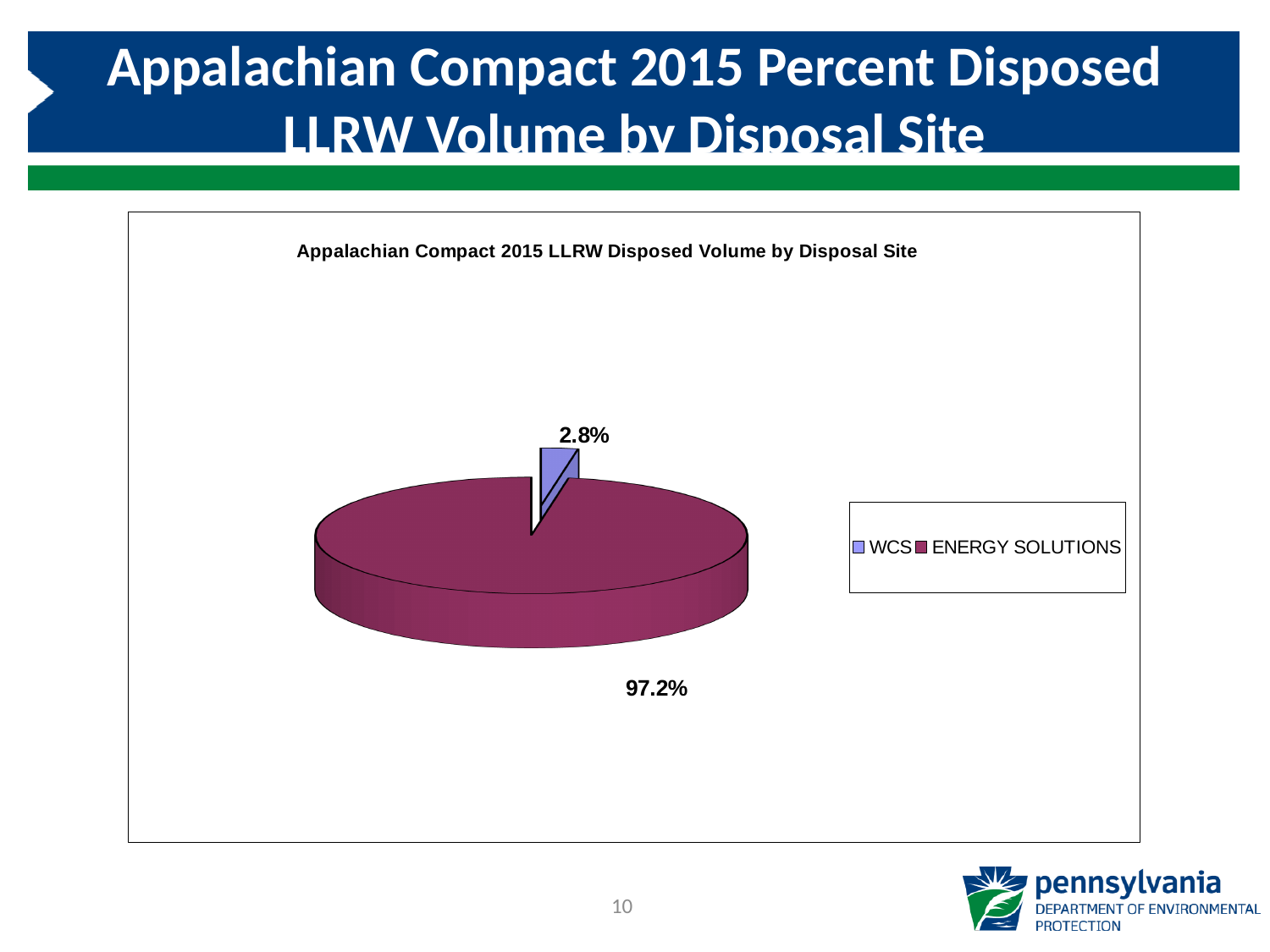
What share of the pie does ENERGY SOLUTIONS account for? 97.2% How many slices does the pie chart have? 2 What is the title of the chart? Appalachian Compact 2015 LLRW Disposed Volume by Disposal Site Which disposal site has the largest share of the pie? ENERGY SOLUTIONS Which is larger, the share for WCS or the share for ENERGY SOLUTIONS? ENERGY SOLUTIONS What is the difference in percentage points between the ENERGY SOLUTIONS share and the WCS share? 94.4 What share of the pie does WCS account for? 2.8% What kind of chart is shown on the slide? pie chart Which disposal site is shown in the purple/magenta colour in the legend? ENERGY SOLUTIONS How many entries does the legend list? 2 Which disposal site has the smallest share of the pie? WCS